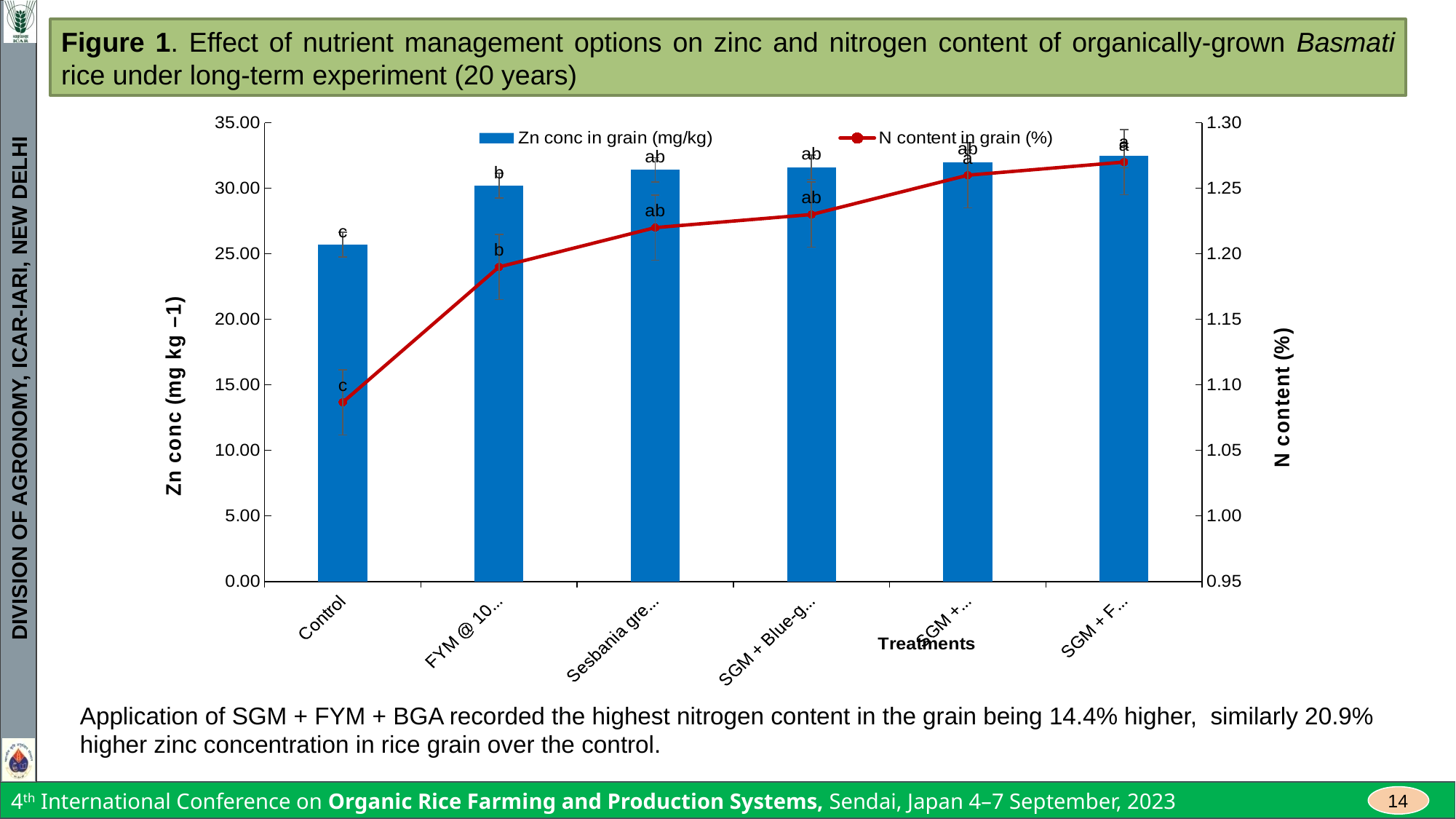
Is the N content in grain for the rightmost treatment (SGM + F...) greater or less than 1.25%? greater What kind of chart is shown on the slide? A combined bar and line chart How many treatment categories are plotted along the x axis of the chart? 6 How many series does the chart legend list? 2 Which is larger: the Zn conc in grain for Control or for the Sesbania treatment? Sesbania treatment Is the Zn conc in grain for Control greater or less than 30.00 mg/kg? less Which treatment has the lowest Zn conc in grain (mg/kg)? Control Is the Zn conc in grain for the Sesbania treatment greater or less than 30.00 mg/kg? greater Which treatment has the lowest N content in grain (%)? Control What is the title of the right-hand vertical axis? N content (%) Does the N content in grain generally rise or fall moving from Control to the rightmost treatment? rise